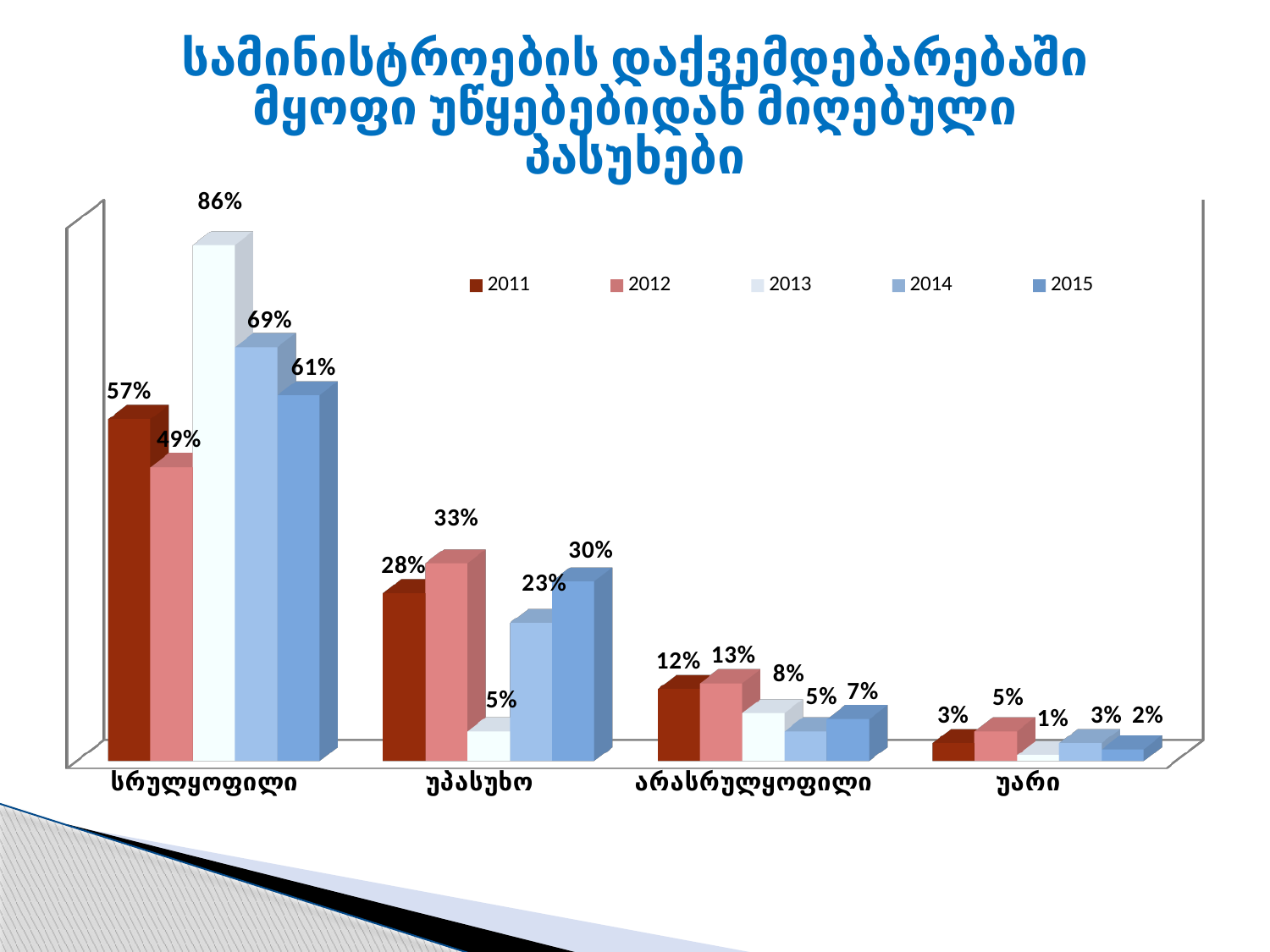
Which year has the lowest value in the უპასუხო category? 2013 What is the difference between the 2014 and 2011 values in the სრულყოფილი category? 12% What kind of chart is shown on the slide? Bar chart What is the value for 2014 in the არასრულყოფილი category? 5% Which is larger in the უპასუხო category: the 2015 value or the 2011 value? 2015 How many series does the legend list? 5 What is the value for 2013 in the სრულყოფილი category? 86% Which year has the highest value in the სრულყოფილი category? 2013 How many categories are shown on the x axis? 4 What is the value for 2012 in the უპასუხო category? 33% What is the value for 2015 in the უარი category? 2% Which years are listed in the legend? 2011, 2012, 2013, 2014, 2015